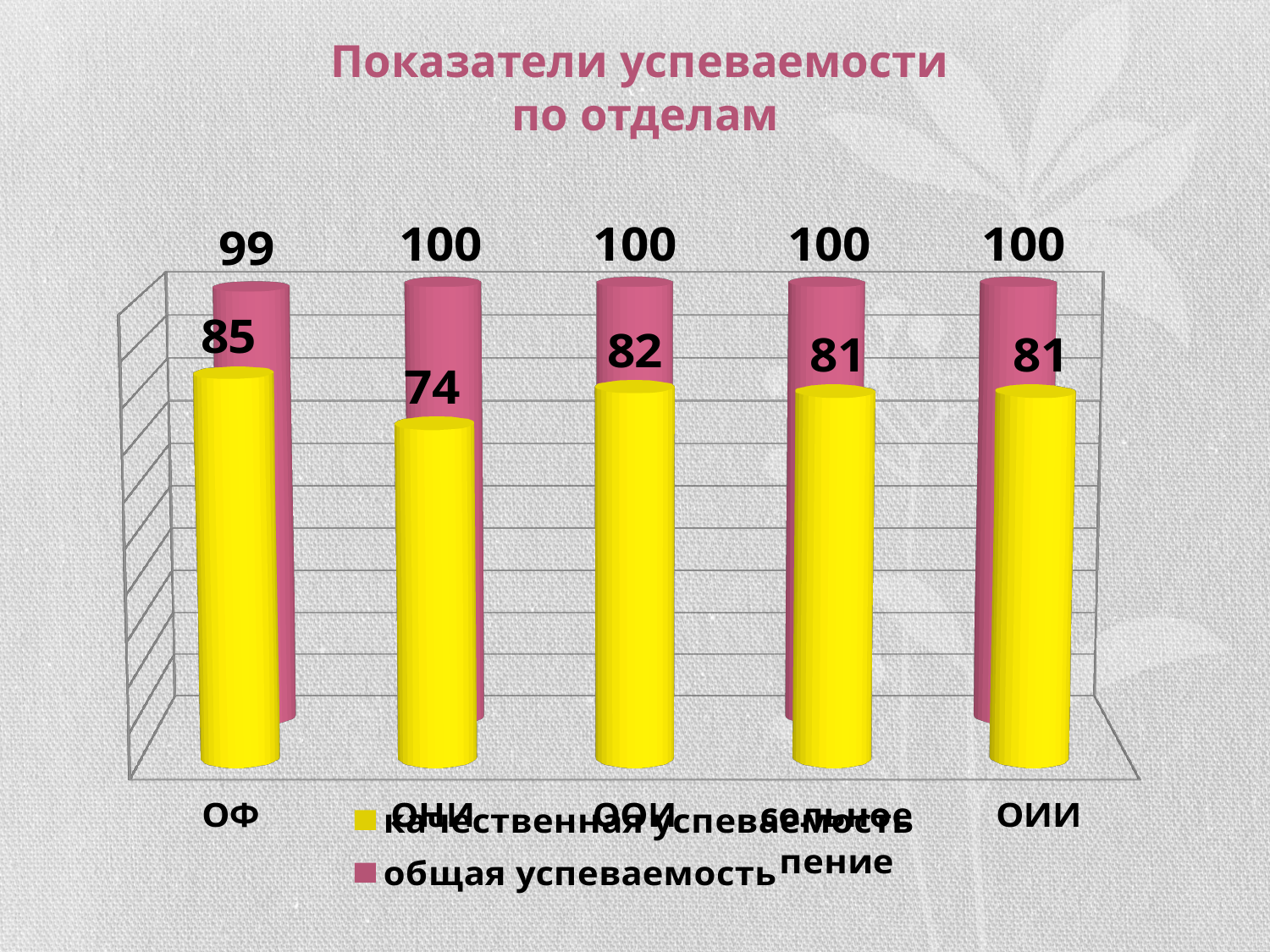
What is the качественная успеваемость value for ОФ? 85 What is the title of the chart? Показатели успеваемости по отделам What is the difference between the качественная успеваемость values for ОФ and ОНИ? 11 What is the общая успеваемость value for ОФ? 99 Which department has the highest качественная успеваемость? ОФ How many series does the legend list? 2 What is the качественная успеваемость value for ООИ? 82 What kind of chart is shown on the slide? bar chart What is the качественная успеваемость value for ОНИ? 74 Which department has the lowest качественная успеваемость? ОНИ Which has the larger качественная успеваемость value, ООИ or ОИИ? ООИ What is the общая успеваемость value for ОИИ? 100